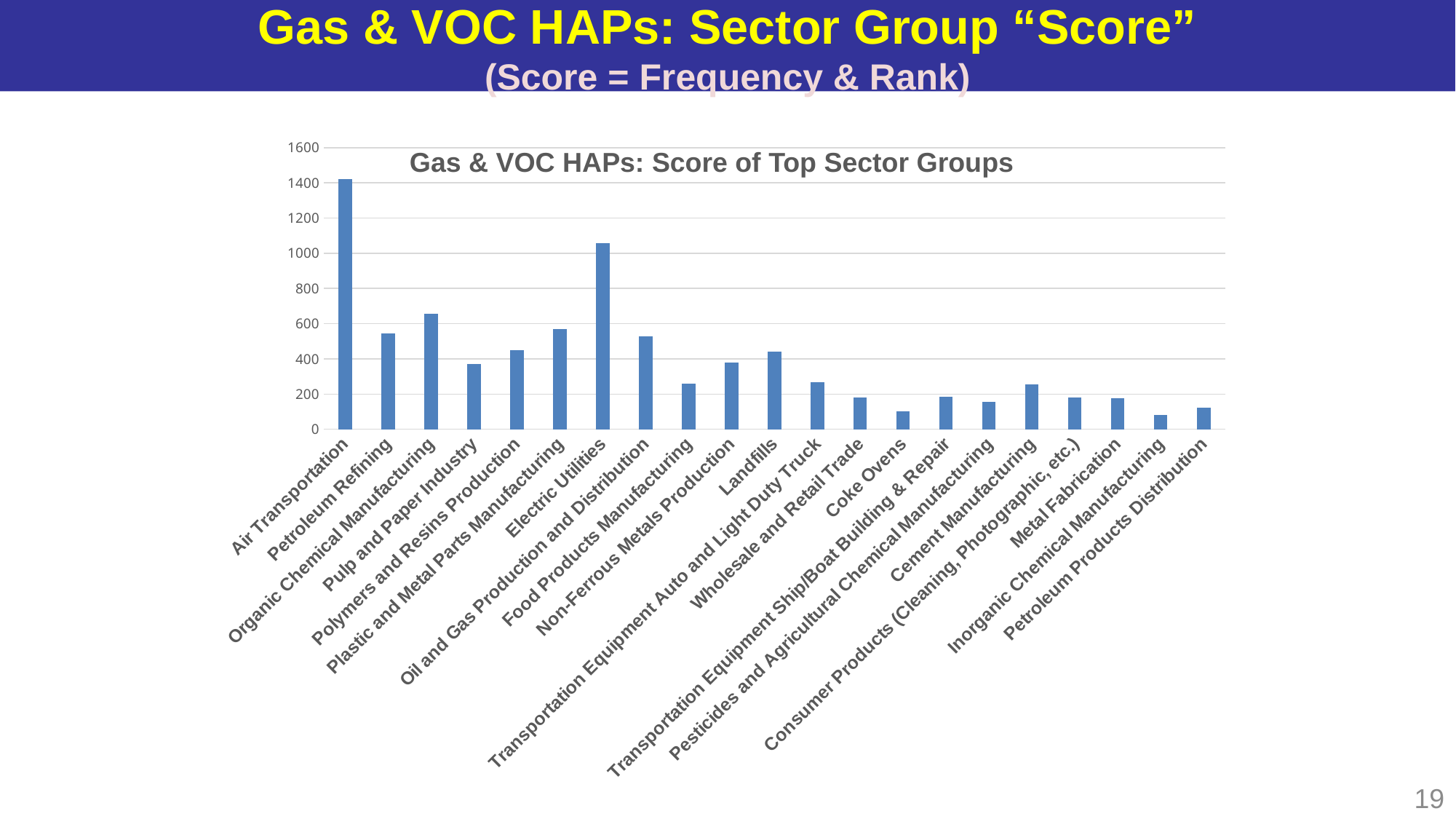
How many sector groups are plotted in the chart? 21 Is the score for Landfills greater or less than 400? greater Is the score for Coke Ovens greater or less than 200? less Is the score for Electric Utilities greater or less than 1000? greater What is the title of the chart? Gas & VOC HAPs: Score of Top Sector Groups Which sector group has the highest score? Air Transportation Which has a higher score, Electric Utilities or Organic Chemical Manufacturing? Electric Utilities Which has a higher score, Polymers and Resins Production or Pulp and Paper Industry? Polymers and Resins Production Do the scores generally rise or fall moving from left to right across the sector groups? fall What kind of chart is shown on the slide? bar chart